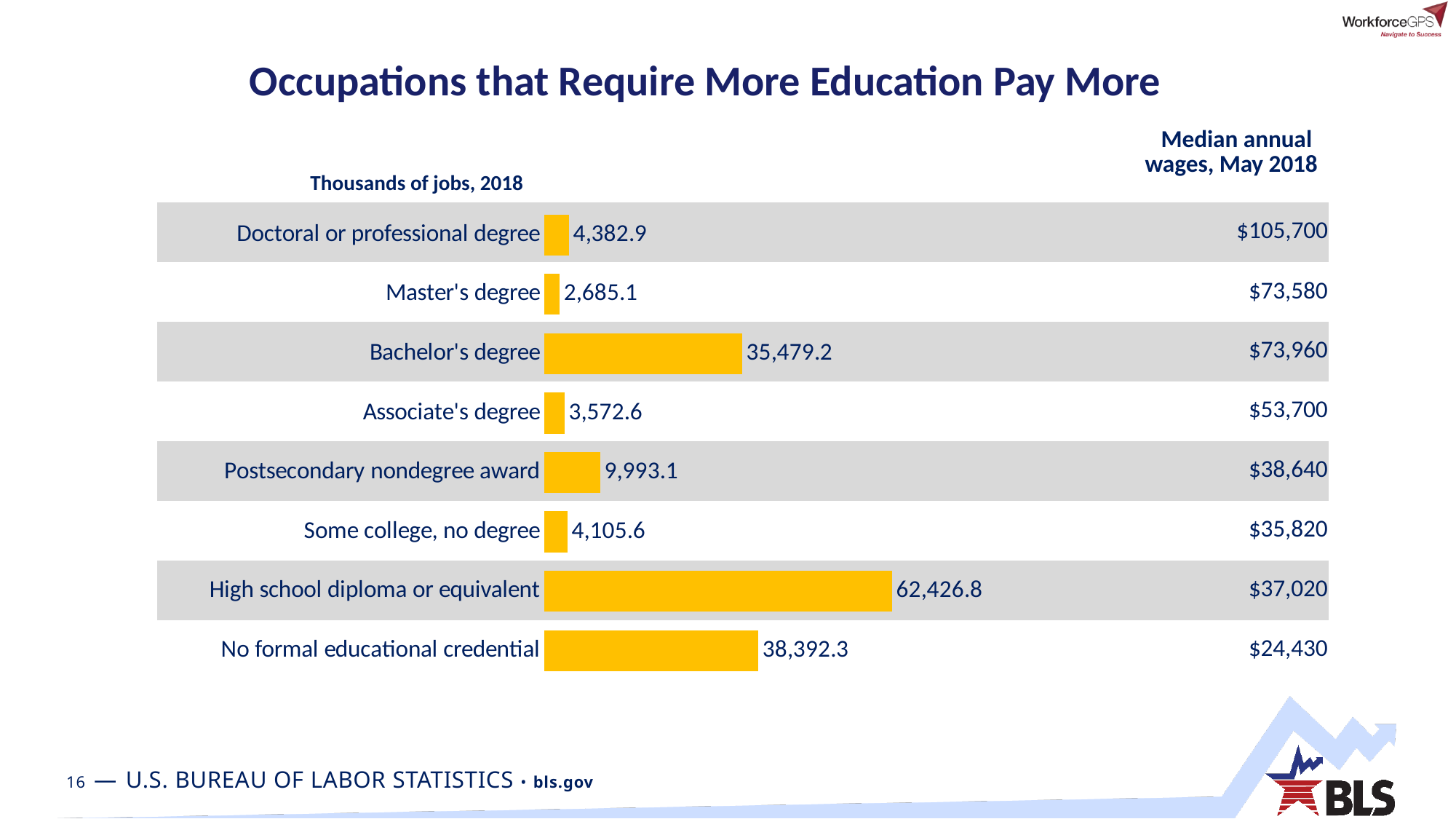
How many education categories are shown in the chart? 8 Which has more jobs in 2018: Associate's degree or Some college, no degree? Some college, no degree How many thousands of jobs in 2018 required a Bachelor's degree? 35,479.2 Which education category has the highest number of jobs in 2018? High school diploma or equivalent What is the median annual wage (May 2018) for occupations with No formal educational credential? $24,430 What is the difference in thousands of jobs between High school diploma or equivalent and No formal educational credential? 24,034.5 What is the title of the slide's chart? Occupations that Require More Education Pay More What is the median annual wage (May 2018) for occupations requiring a Doctoral or professional degree? $105,700 What kind of chart is used to show thousands of jobs in 2018? Bar chart Which education category has the lowest number of jobs in 2018? Master's degree How many thousands of jobs in 2018 required a Postsecondary nondegree award? 9,993.1 Which has a higher median annual wage: Master's degree or Bachelor's degree? Bachelor's degree